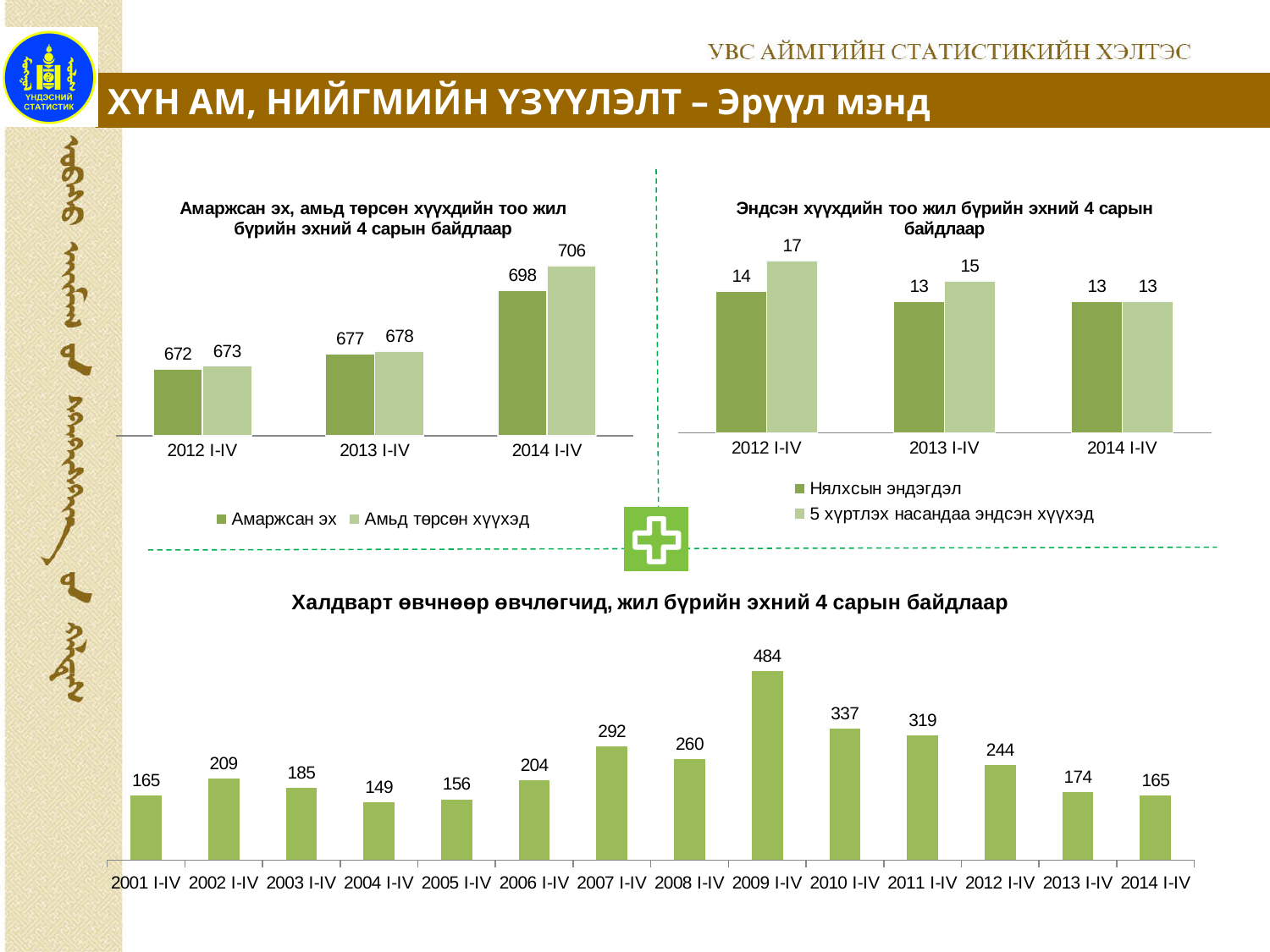
In the bottom chart (Халдварт өвчнөөр өвчлөгчид), what is the difference between the values for 2010 I-IV and 2011 I-IV? 18 In the bottom chart (Халдварт өвчнөөр өвчлөгчид), which year has the lowest value? 2004 I-IV What kind of chart is the bottom chart (Халдварт өвчнөөр өвчлөгчид)? bar chart In the top-right chart (Эндсэн хүүхдийн тоо), does the value for 5 хүртлэх насандаа эндсэн хүүхэд rise or fall from 2012 I-IV to 2014 I-IV? fall In the bottom chart (Халдварт өвчнөөр өвчлөгчид), what is the value for 2009 I-IV? 484 In the top-left chart (Амаржсан эх, амьд төрсөн хүүхдийн тоо), what is the difference between Амьд төрсөн хүүхэд and Амаржсан эх in 2014 I-IV? 8 In the top-right chart (Эндсэн хүүхдийн тоо), what is the value for 5 хүртлэх насандаа эндсэн хүүхэд in 2012 I-IV? 17 In the top-left chart (Амаржсан эх, амьд төрсөн хүүхдийн тоо), what is the value for Амьд төрсөн хүүхэд in 2012 I-IV? 673 In the top-right chart (Эндсэн хүүхдийн тоо), in which year is the value for Нялхсын эндэгдэл highest? 2012 I-IV In the bottom chart (Халдварт өвчнөөр өвчлөгчид), how many years are shown on the x axis? 14 In the top-left chart (Амаржсан эх, амьд төрсөн хүүхдийн тоо), what is the value for Амаржсан эх in 2014 I-IV? 698 In the top-left chart (Амаржсан эх, амьд төрсөн хүүхдийн тоо), how many series does the legend list? 2